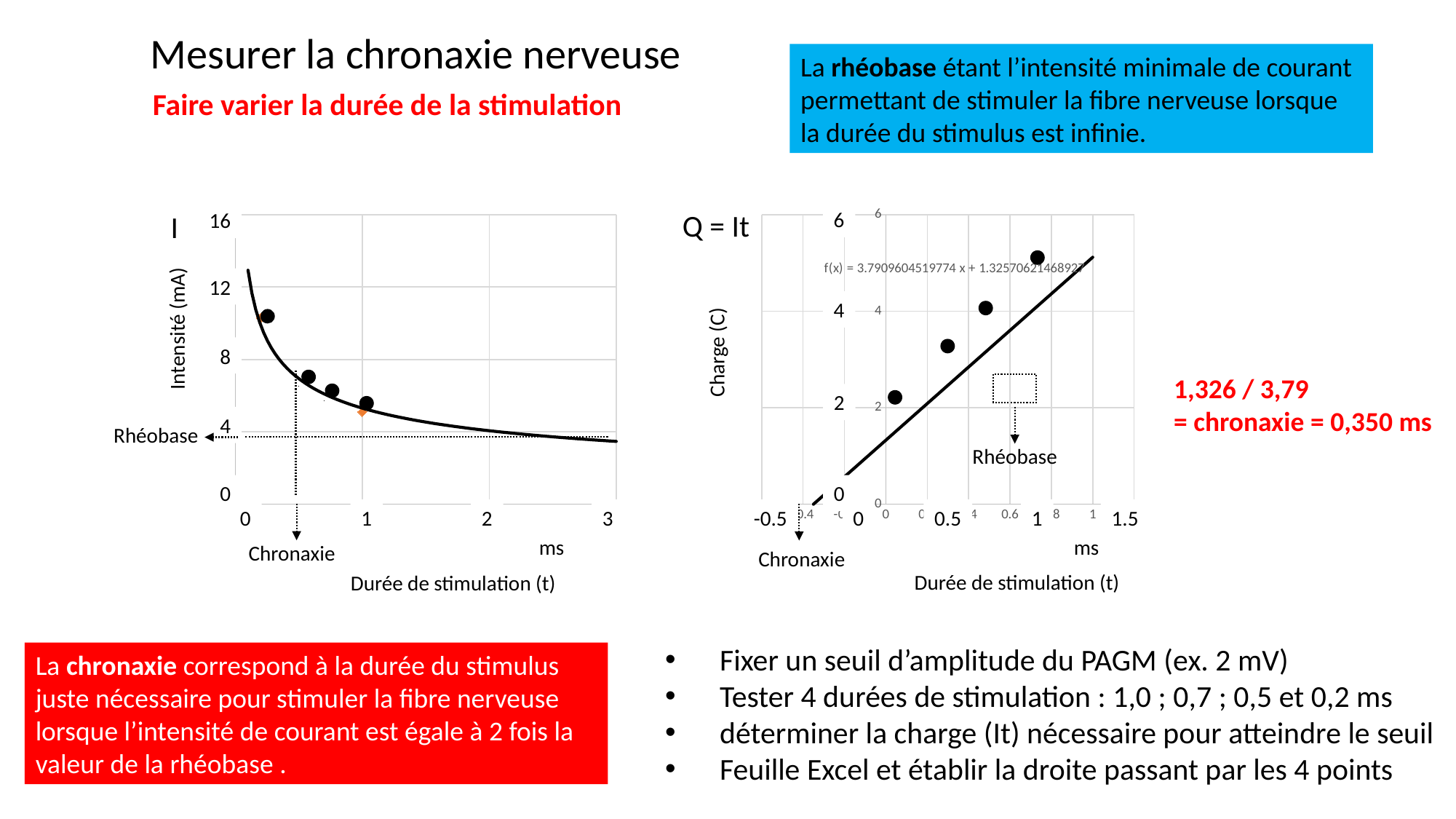
On the right chart (Charge), is the charge at a stimulation duration of 1 ms greater or less than 4 C? greater On the left chart (Intensité), is the intensity at a stimulation duration of 1 ms greater or less than 8 mA? less How many data points are plotted on the left chart (Intensité)? 4 What kind of chart is the left chart (Intensité vs Durée de stimulation)? scatter chart On the left chart (Intensité), which stimulation duration has the highest intensity: 0.2 ms or 1 ms? 0.2 ms On the right chart (Charge), do the plotted values rise or fall as the stimulation duration increases? rise On the left chart (Intensité), is the intensity at the shortest stimulation duration (0.2 ms) greater or less than 8 mA? greater How many data points are plotted on the right chart (Charge)? 4 What is the y-axis label of the right chart? Charge (C) What kind of chart is the right chart (Charge vs Durée de stimulation)? scatter chart On the left chart (Intensité), do the plotted values rise or fall as the stimulation duration increases? fall